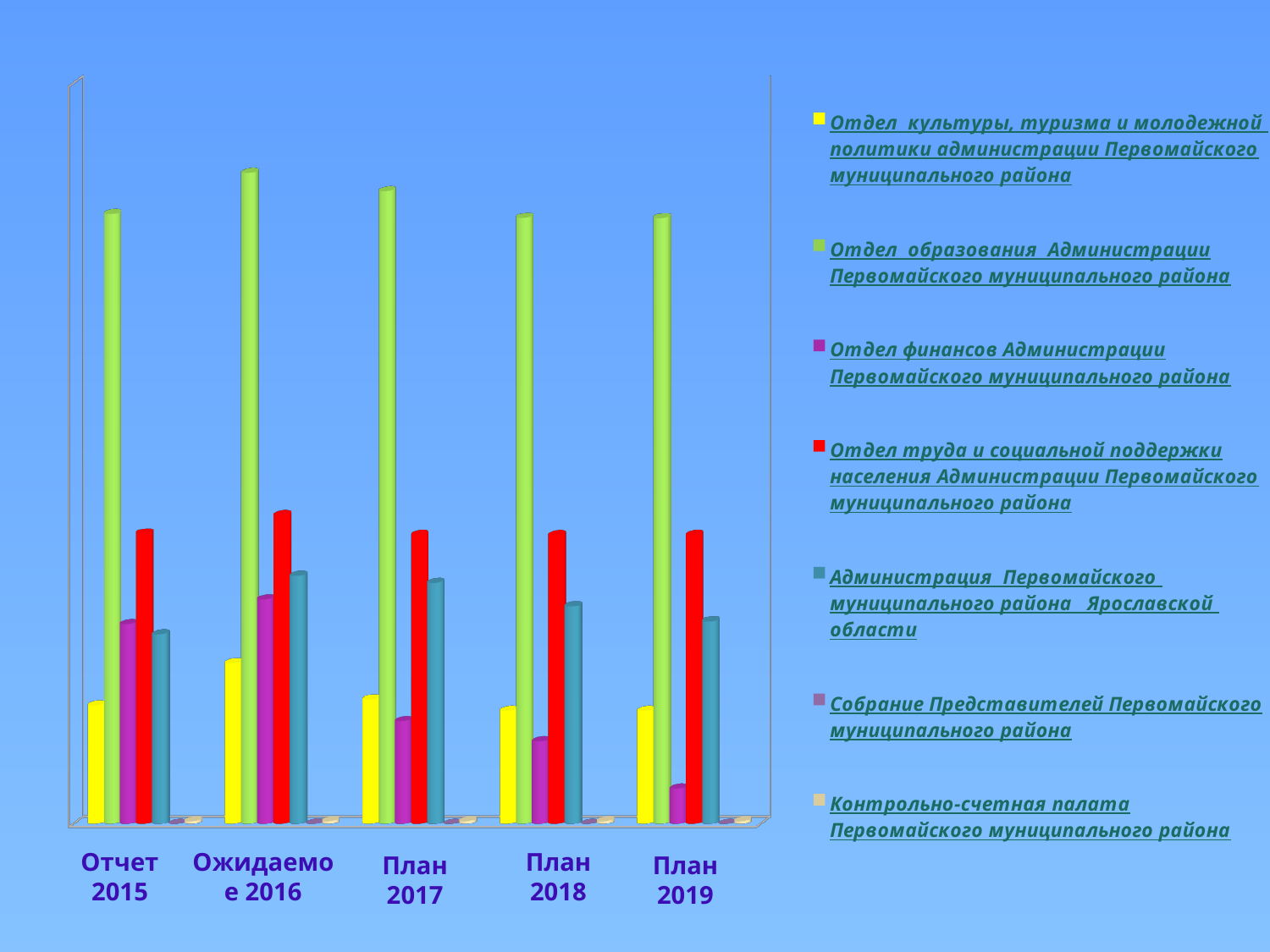
In the Отчет 2015 category, which is larger: the value for Отдел труда и социальной поддержки населения or the value for Отдел финансов? Отдел труда и социальной поддержки населения In which category does the Отдел труда и социальной поддержки населения series reach its highest value? Ожидаемое 2016 Which series is shown in red in the chart? Отдел труда и социальной поддержки населения Администрации Первомайского муниципального района How many categories are shown along the x axis of the chart? 5 In which category does the Отдел финансов Администрации Первомайского муниципального района series have its lowest value? План 2019 How many series does the chart's legend list? 7 In the План 2019 category, which is larger: the value for Отдел культуры, туризма и молодежной политики or the value for Отдел финансов? Отдел культуры, туризма и молодежной политики What kind of chart is shown on the slide? bar chart Does the value for Отдел финансов Администрации Первомайского муниципального района rise or fall from Ожидаемое 2016 to План 2019? fall Which series has the highest value in the Отчет 2015 category? Отдел образования Администрации Первомайского муниципального района In which category does the Отдел образования Администрации Первомайского муниципального района series reach its highest value? Ожидаемое 2016 What colour represents the Отдел образования Администрации Первомайского муниципального района series? green